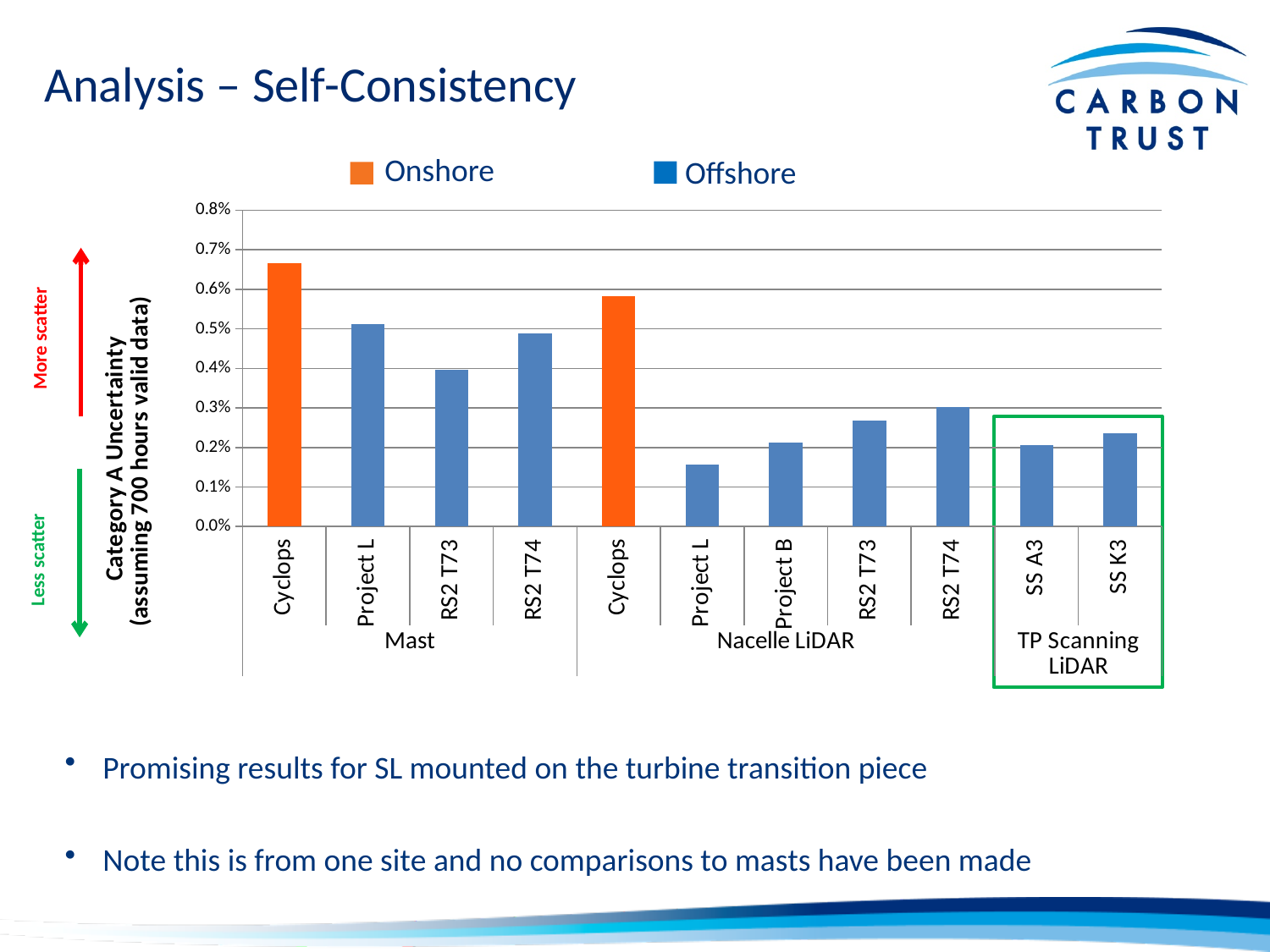
Which bar has the highest Category A Uncertainty in the chart? Cyclops (Mast) Which is larger in the Nacelle LiDAR group: RS2 T74 or Project B? RS2 T74 How many bars are plotted in the chart? 11 Which is larger: the Cyclops bar in the Mast group or the Cyclops bar in the Nacelle LiDAR group? Cyclops in the Mast group Is the value for Project L in the Nacelle LiDAR group greater or less than 0.2%? less How many series does the chart legend list? 2 Is the value for RS2 T73 in the Mast group greater or less than 0.5%? less What kind of chart is shown on the slide? bar chart Is the value for Cyclops in the Nacelle LiDAR group greater or less than 0.5%? greater Which bar has the lowest Category A Uncertainty in the chart? Project L (Nacelle LiDAR) Which legend entry is shown in orange? Onshore